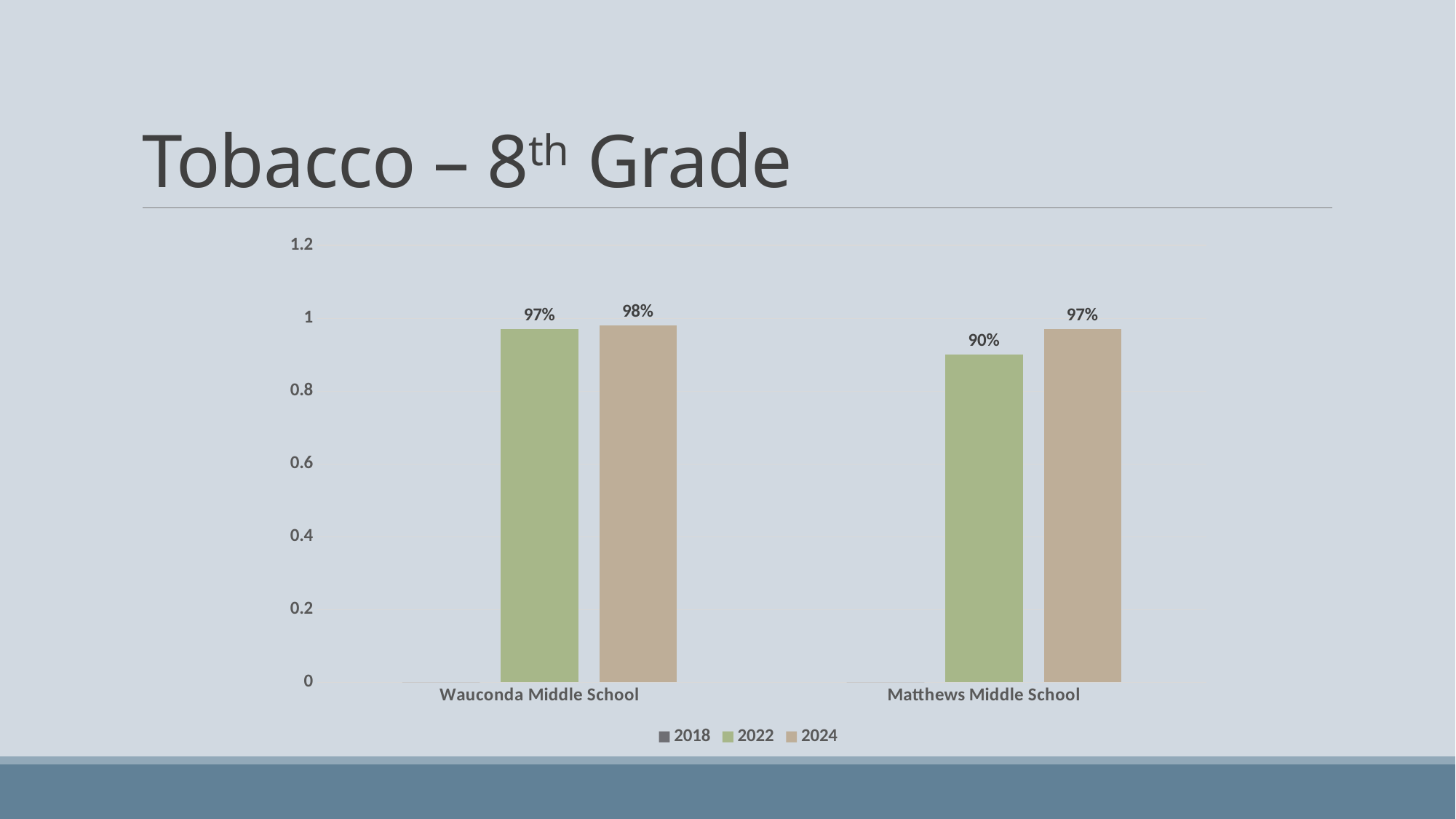
How many schools are shown on the x axis? 2 What is the difference between the 2024 and 2022 values for Matthews Middle School? 7% What is the 2022 value for Matthews Middle School? 90% What kind of chart is shown on the slide? Bar chart How many series does the legend list? 3 Which is larger for Matthews Middle School, the 2022 value or the 2024 value? 2024 Is the 2022 value for Matthews Middle School greater or less than 0.8? greater What is the 2024 value for Matthews Middle School? 97% Which school has the lowest 2022 value? Matthews Middle School What is the difference between the 2024 values for Wauconda Middle School and Matthews Middle School? 1% What is the 2024 value for Wauconda Middle School? 98% What is the 2022 value for Wauconda Middle School? 97%